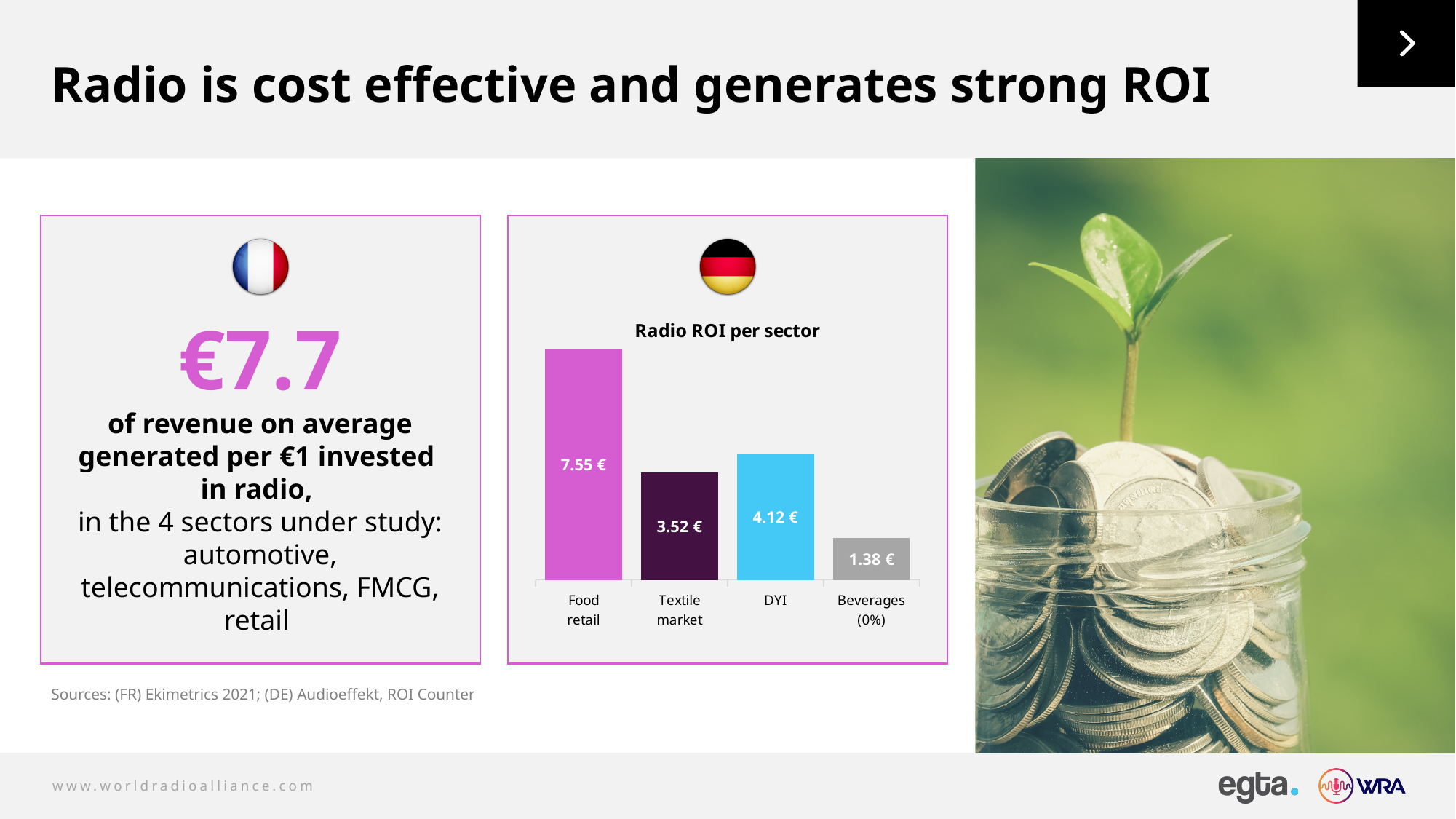
What is the difference in Radio ROI between DYI and Beverages (0%)? 2.74 € What is the Radio ROI for Beverages (0%)? 1.38 € How many sectors are shown in the Radio ROI per sector chart? 4 Which sector has the lowest Radio ROI? Beverages (0%) What is the Radio ROI for Food retail? 7.55 € Which sector has the highest Radio ROI? Food retail What is the difference in Radio ROI between Food retail and Textile market? 4.03 € What is the title of the chart? Radio ROI per sector Which has a higher Radio ROI, Textile market or DYI? DYI What is the Radio ROI for Textile market? 3.52 € What is the Radio ROI for DYI? 4.12 € What kind of chart is the Radio ROI per sector chart? Bar chart